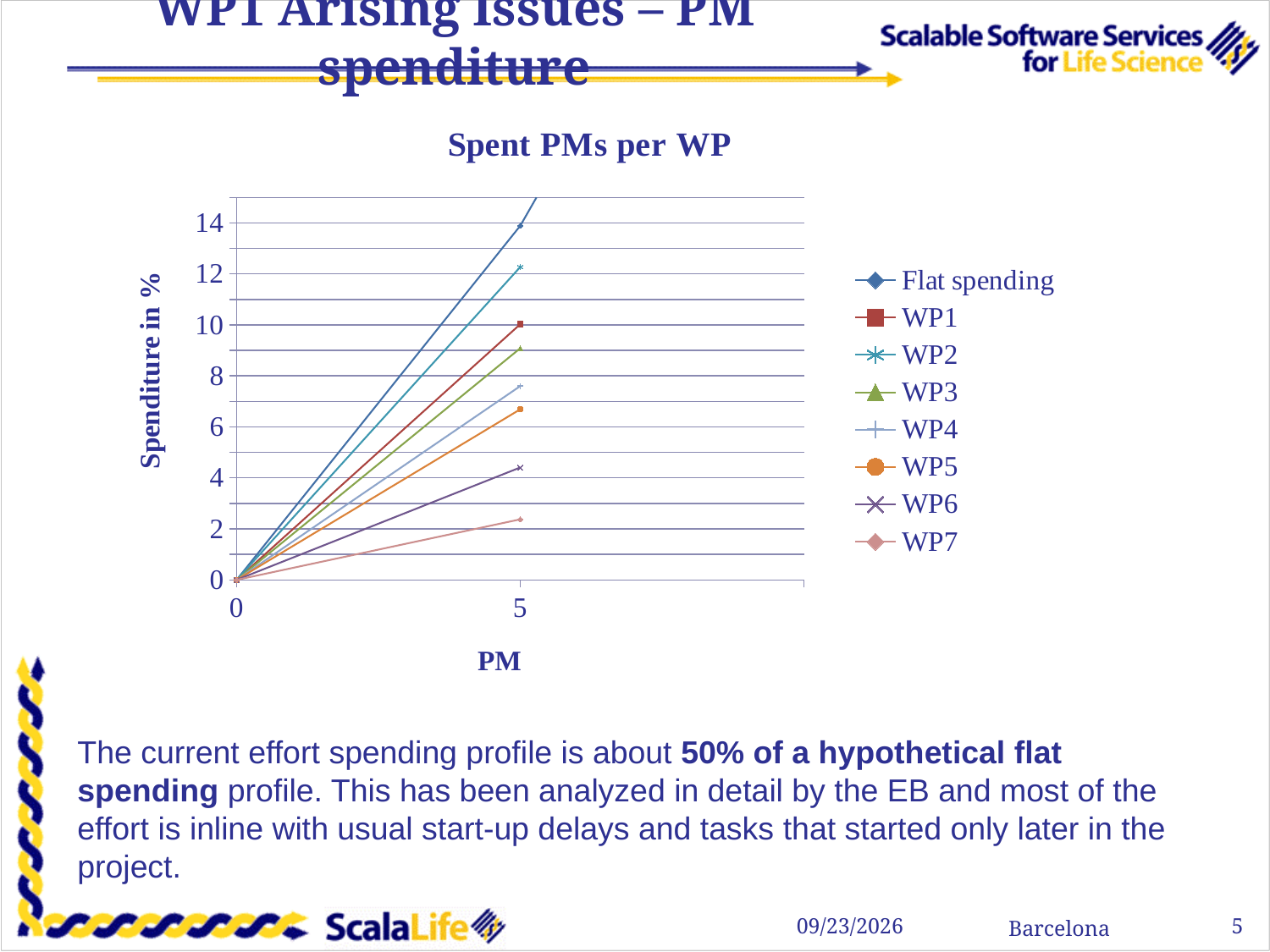
At PM 5, which is larger, WP1 or WP6? WP1 Is the value for WP3 at PM 5 greater or less than 8? greater Is the value for WP7 at PM 5 greater or less than 4? less Is the value for WP4 at PM 5 greater or less than 8? less How many series does the chart legend list? 8 What kind of chart is shown on the slide? line chart What is the title of the chart? Spent PMs per WP What is the label of the vertical axis? Spenditure in % Which series has the highest value at PM 5? Flat spending Do the series values rise or fall as PM increases from 0 to 5? rise Which series has the lowest value at PM 5? WP7